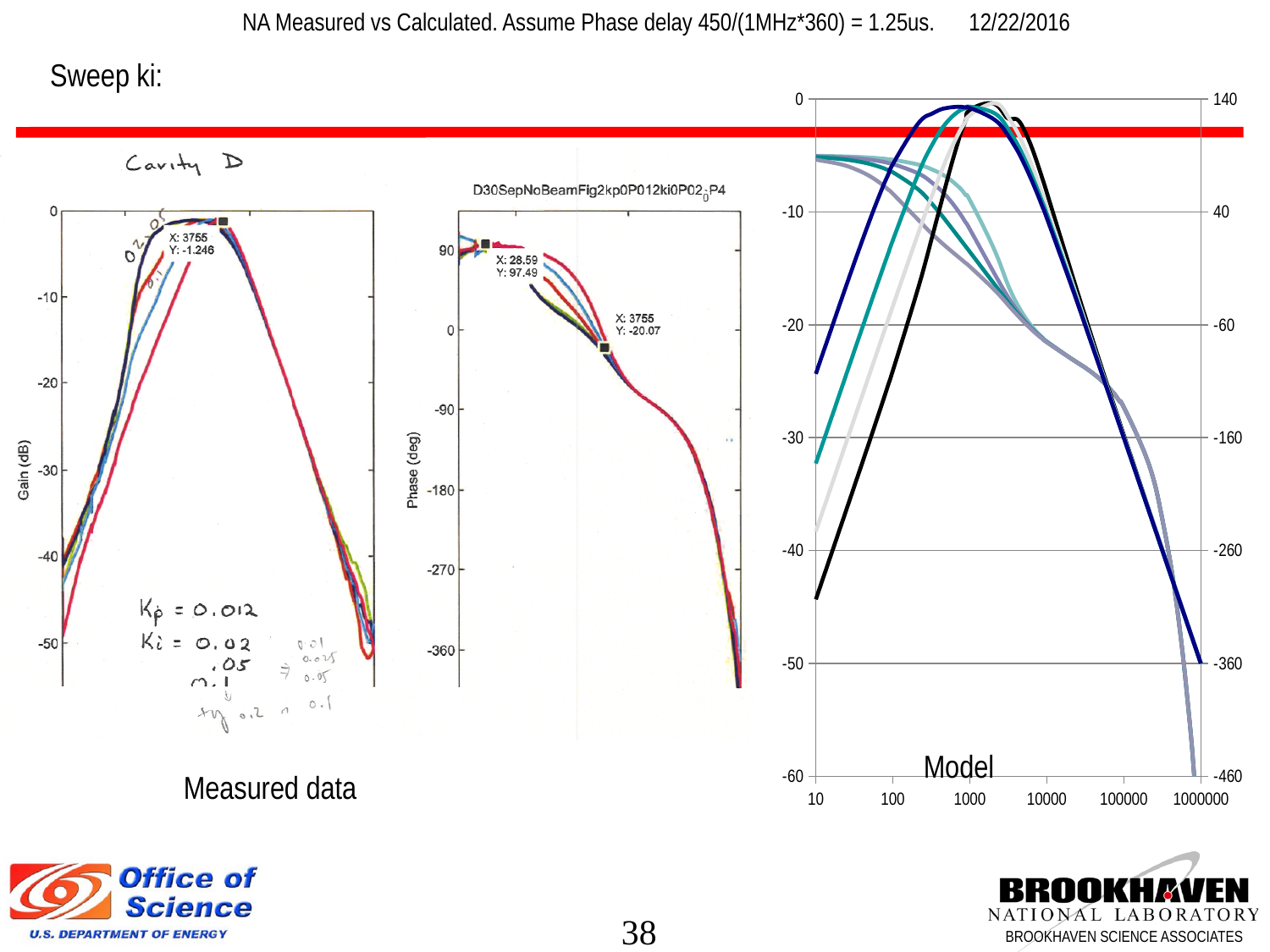
In the Model chart, is the value of the black line at x = 10 greater or less than -40? less In the Model chart, does the black line rise or fall as x increases from 10000 to 1000000? fall In the Model chart, does the dark blue line rise or fall as x increases from 10 to 1000? rise In the Model chart, is the value of the dark blue line at x = 10 greater or less than -30? greater In the measured gain plot (left, Cavity D), what Y value is shown in the data tip at X: 3755? -1.246 What kind of chart is the Model chart on the right of the slide? line chart In the measured phase plot (middle), what Y value is shown in the data tip at X: 28.59? 97.49 In the Model chart, what is the smallest value shown on the x axis? 10 In the Model chart, what is the largest value shown on the x axis? 1000000 In the Model chart, which line has the lower value at x = 10, the black line or the dark blue line? black line In the measured phase plot (middle), what Y value is shown in the data tip at X: 3755? -20.07 In the Model chart, is the value of the light gray line at x = 10 greater or less than -30? less